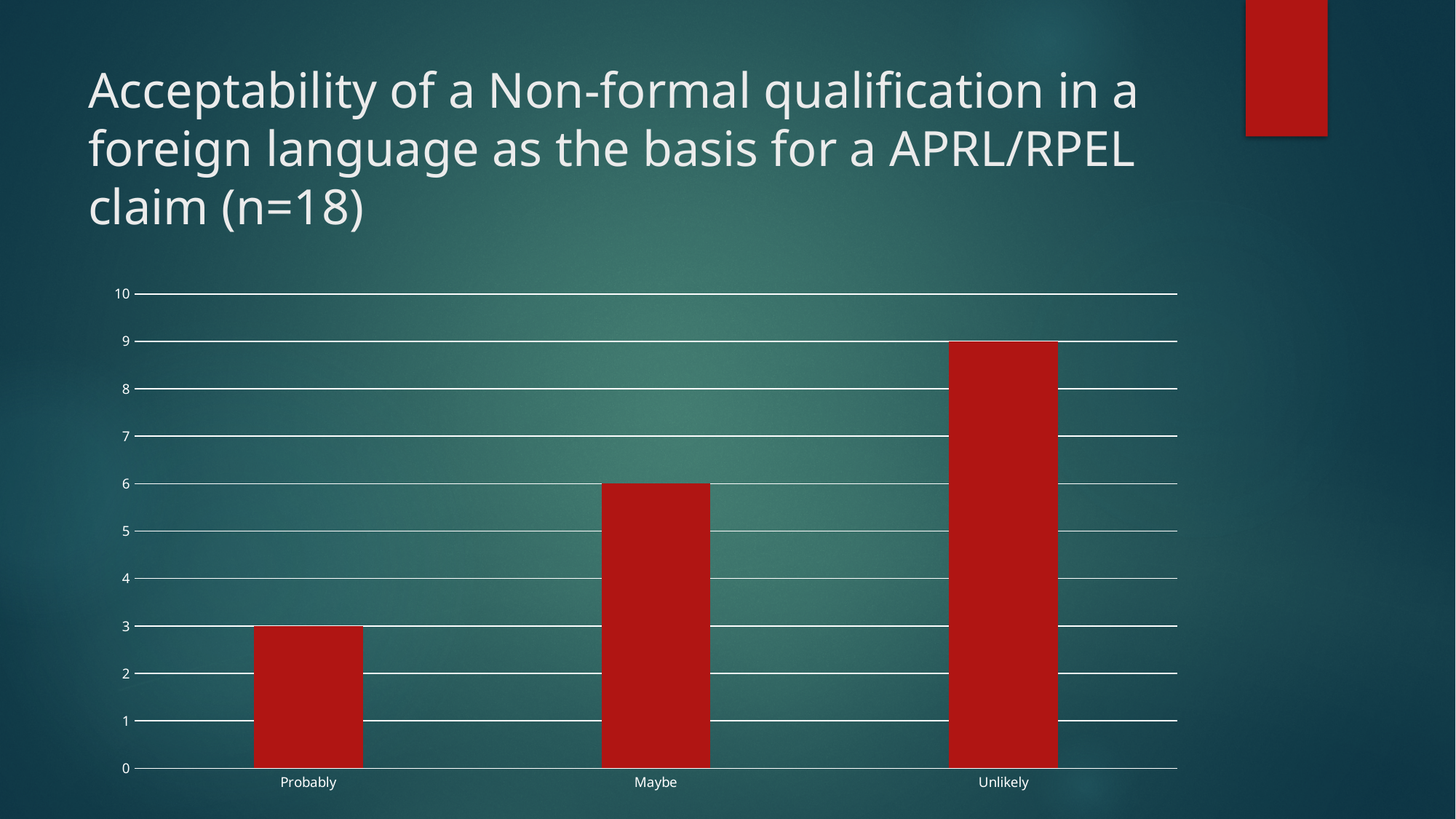
What is the value for Probably? 3 Which category has the highest value? Unlikely What kind of chart is shown on the slide? bar chart Which category has the lowest value? Probably How many categories are shown on the x axis? 3 Do the values rise or fall from Probably to Unlikely along the x axis? rise What is the difference between the values for Maybe and Probably? 3 Which is larger, the value for Maybe or the value for Unlikely? Unlikely What is the difference between the values for Unlikely and Probably? 6 What is the value for Maybe? 6 What is the value for Unlikely? 9 Is the value for Maybe greater or less than 5? greater